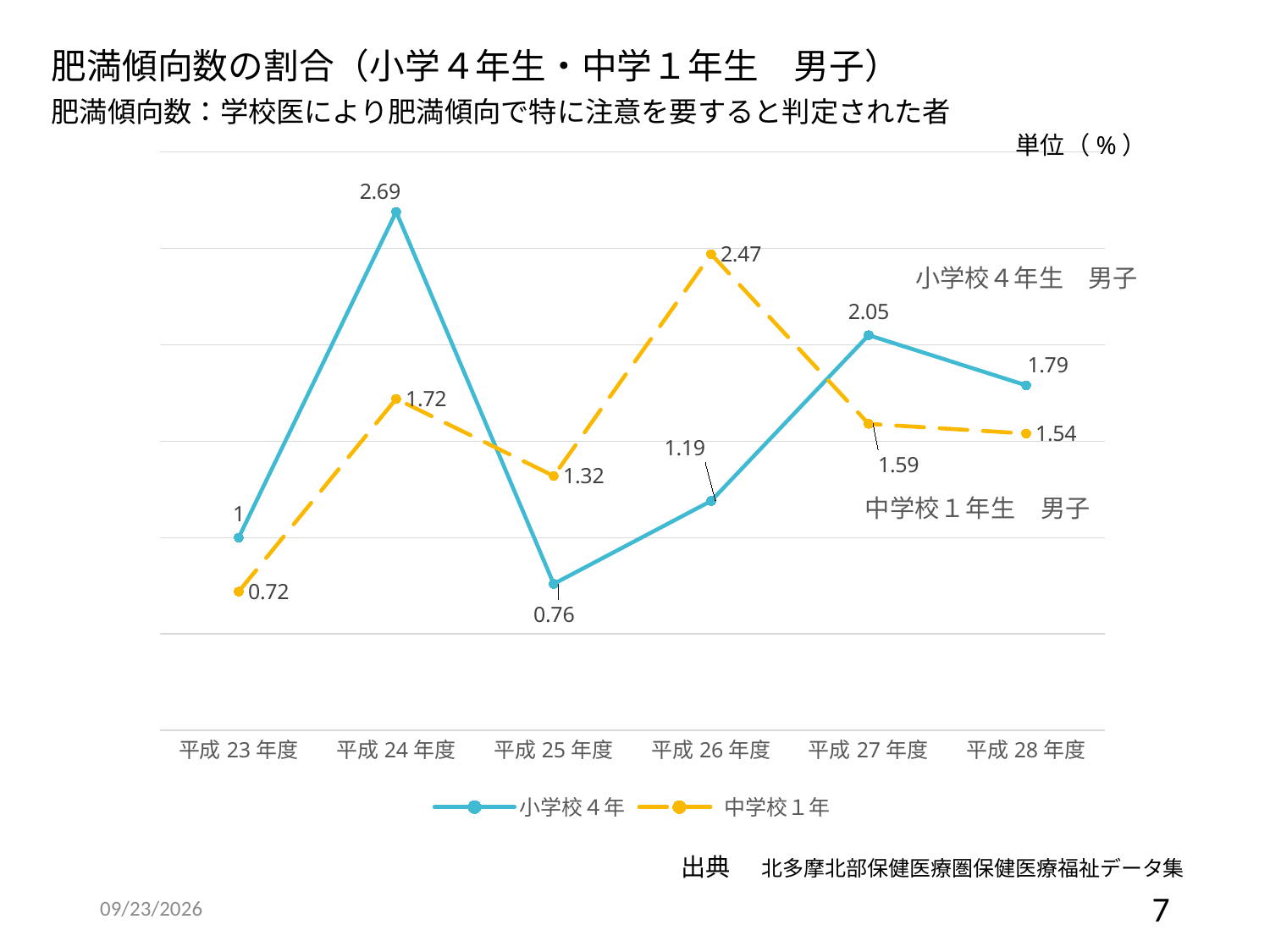
In which year does the 中学校１年 series have its lowest value? 平成 23 年度 How many years are shown on the x axis? 6 What is the value for 小学校４年 in 平成 24 年度? 2.69 What is the value for 小学校４年 in 平成 25 年度? 0.76 What is the difference between the 小学校４年 and 中学校１年 values in 平成 28 年度? 0.25 What kind of chart is shown on the slide? Line chart What is the value for 中学校１年 in 平成 23 年度? 0.72 What is the value for 中学校１年 in 平成 26 年度? 2.47 How many series does the legend list? 2 Does the 小学校４年 series rise or fall from 平成 27 年度 to 平成 28 年度? Fall Which series has the larger value in 平成 26 年度, 小学校４年 or 中学校１年? 中学校１年 In which year does the 小学校４年 series reach its highest value? 平成 24 年度